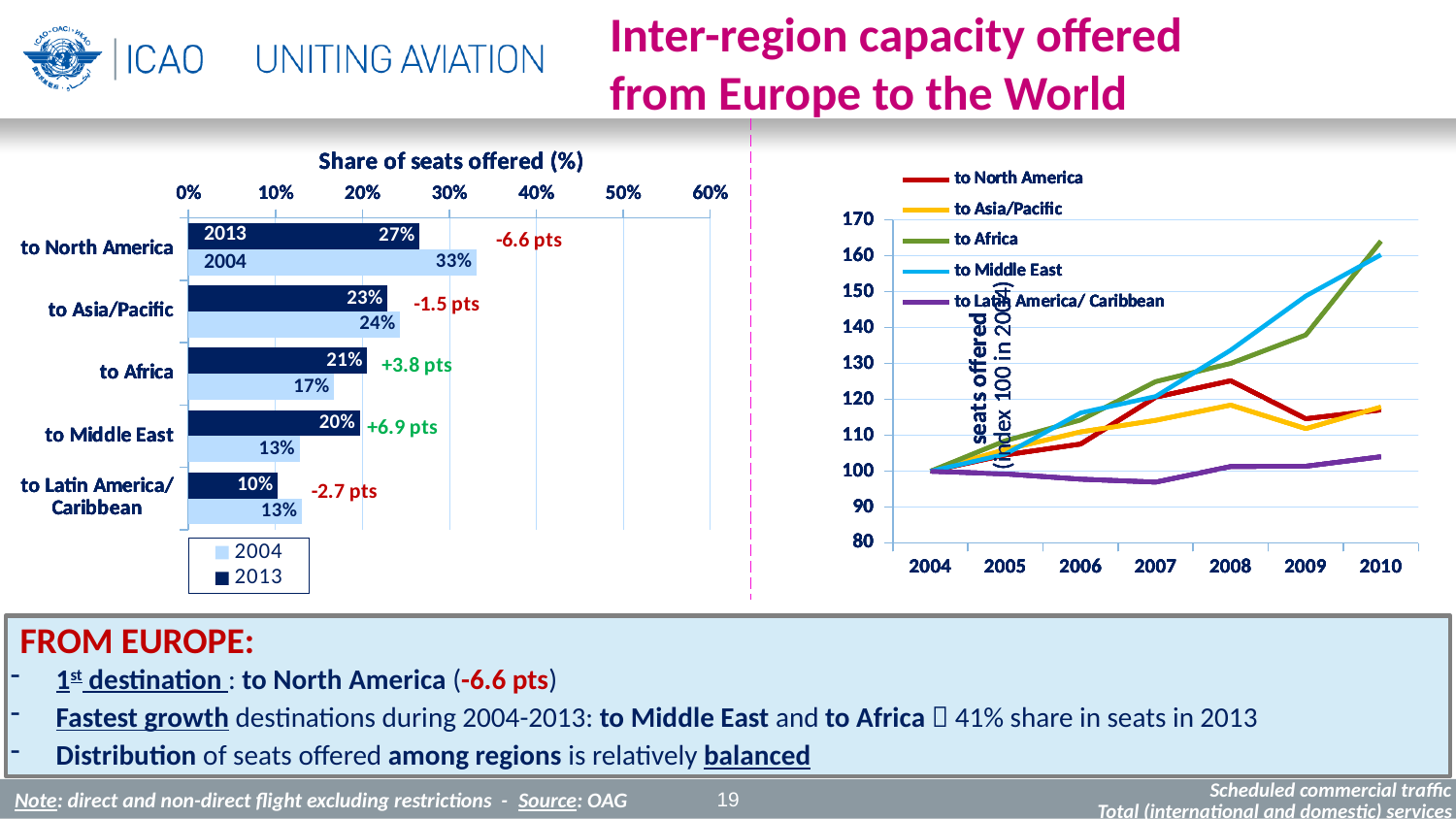
In the 'Share of seats offered (%)' chart, is the 2013 share for to Asia/Pacific larger or smaller than the 2013 share for to Africa? larger In the 'Share of seats offered (%)' chart, which region has the lowest 2013 share? to Latin America/ Caribbean What type of chart is the chart on the right side of the slide? line chart In the 'Share of seats offered (%)' chart, what is the difference between the 2004 and 2013 shares for to Africa? 4 percentage points How many series does the legend of the line chart on the right list? 5 How many regions are shown in the 'Share of seats offered (%)' chart? 5 In the 'Share of seats offered (%)' chart, which region has the highest 2004 share? to North America In the line chart on the right, is the 2010 value for to Latin America/ Caribbean greater or less than 110? less In the line chart on the right, is the 2010 value for to Africa greater or less than 150? greater In the 'Share of seats offered (%)' chart, what is the 2013 share for to North America? 27% How many series does the legend of the 'Share of seats offered (%)' chart list? 2 In the 'Share of seats offered (%)' chart, what is the 2004 share for to Middle East? 13%